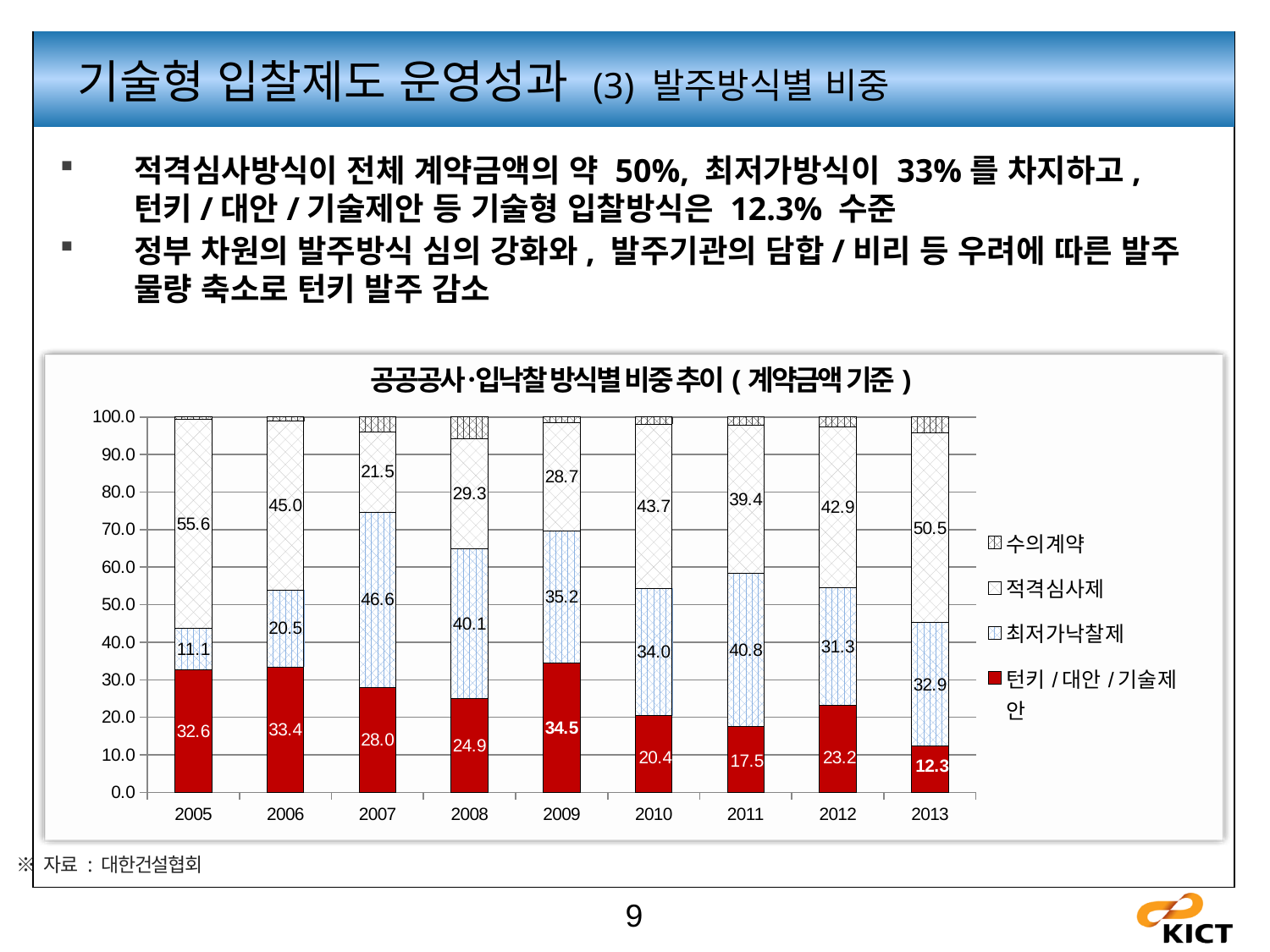
What is the title of the chart? 공공공사·입낙찰 방식별 비중 추이 (계약금액 기준) In which year is the 턴키/대안/기술제안 value highest? 2009 What is the value of 최저가낙찰제 in 2007? 46.6 What is the value of 적격심사제 in 2005? 55.6 Is the 적격심사제 value in 2013 greater or less than 40.0? greater In which year is the 턴키/대안/기술제안 value lowest? 2013 Which is larger, the 최저가낙찰제 value in 2011 or in 2012? 2011 What is the value of 턴키/대안/기술제안 in 2013? 12.3 What is the difference between the 턴키/대안/기술제안 values in 2005 and 2013? 20.3 How many years are shown on the x axis? 9 What kind of chart is shown? Stacked bar chart How many series does the legend list? 4